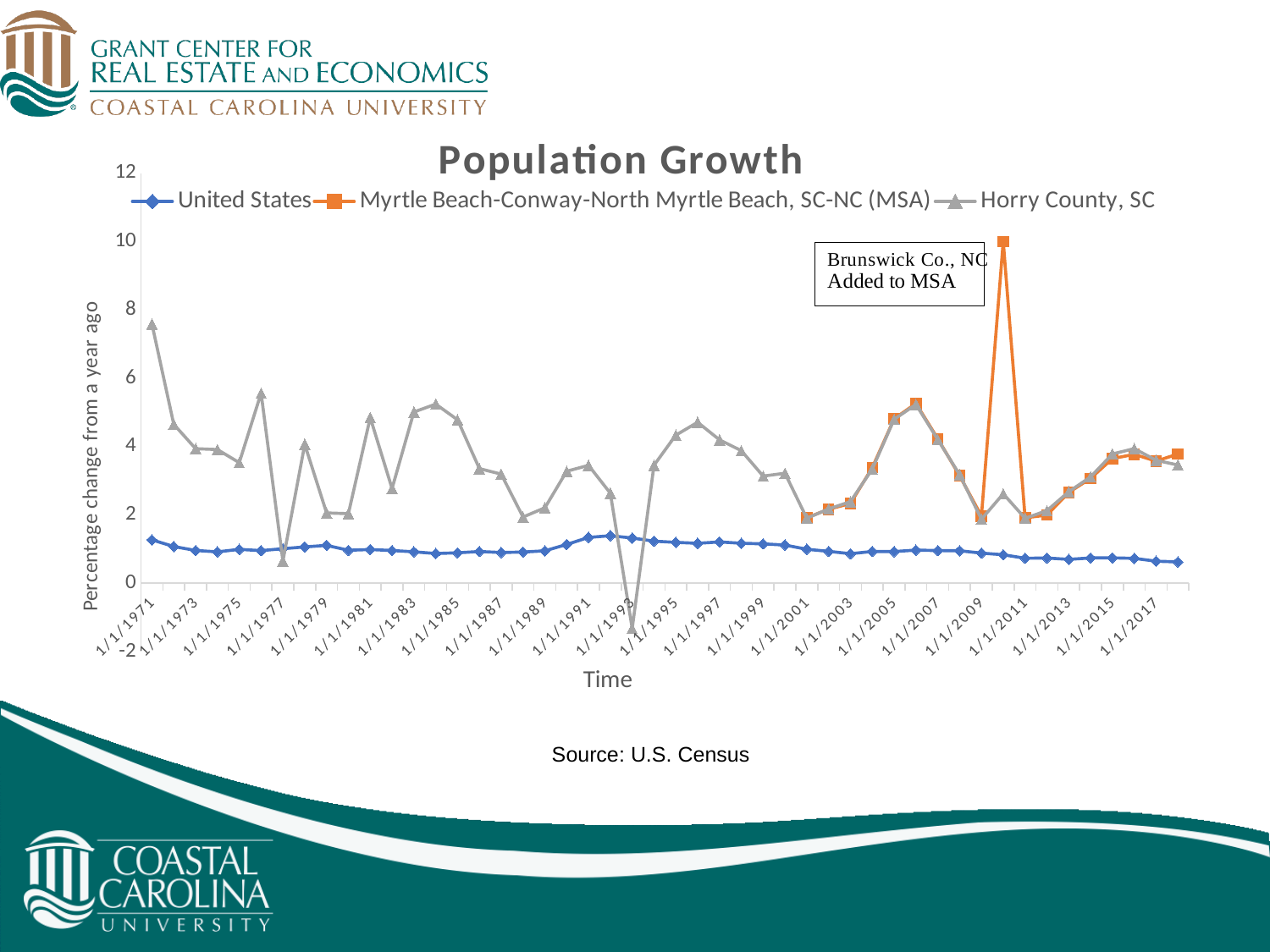
How many series does the legend list? 3 Is the value for Myrtle Beach-Conway-North Myrtle Beach, SC-NC (MSA) at 1/1/2011 greater or less than 8? less What kind of chart is shown on the slide? line chart Does the United States series rise or fall from 1/1/2009 to 1/1/2017? fall At 1/1/2005, which is larger: the value for Horry County, SC or the value for United States? Horry County, SC Is the value for Horry County, SC at 1/1/1993 greater or less than 0? less What is the label on the vertical axis of the chart? Percentage change from a year ago Is the value for Horry County, SC at 1/1/1971 greater or less than 6? greater Which series has the lowest value at 1/1/2005? United States What is the title of the chart? Population Growth